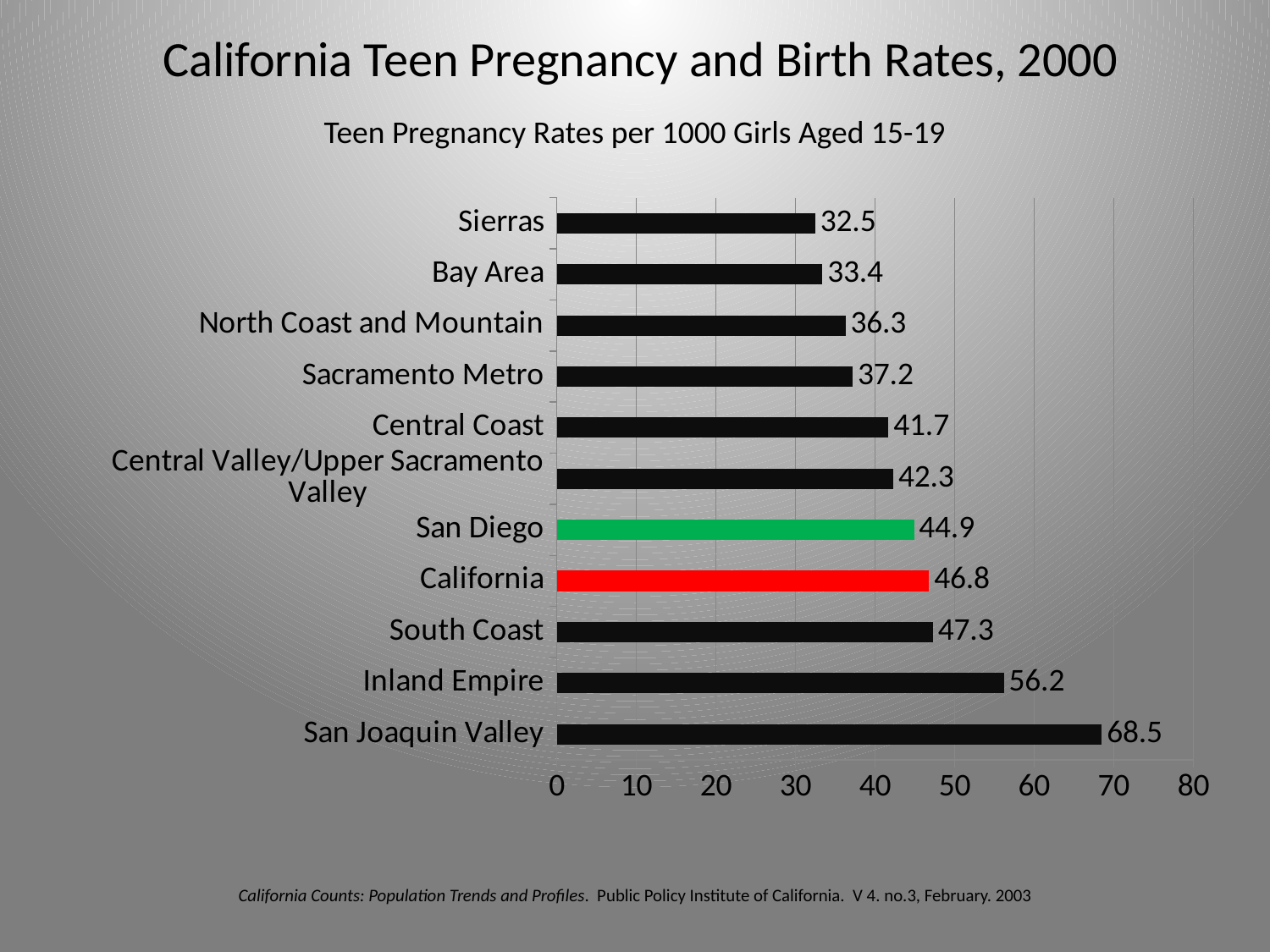
Which has a higher teen pregnancy rate, the Bay Area or Sacramento Metro? Sacramento Metro Which region has the highest teen pregnancy rate? San Joaquin Valley What is the difference between the California rate and the San Diego rate? 1.9 What is the teen pregnancy rate for the Inland Empire? 56.2 Which region has the lowest teen pregnancy rate? Sierras What is the value shown for California as a whole? 46.8 How many categories are shown on the chart? 11 What is the teen pregnancy rate for San Diego? 44.9 Is the value for the Central Coast greater or less than 40? greater Which bar is coloured red? California What is the difference between the San Joaquin Valley rate and the Inland Empire rate? 12.3 What kind of chart is shown on the slide? Bar chart